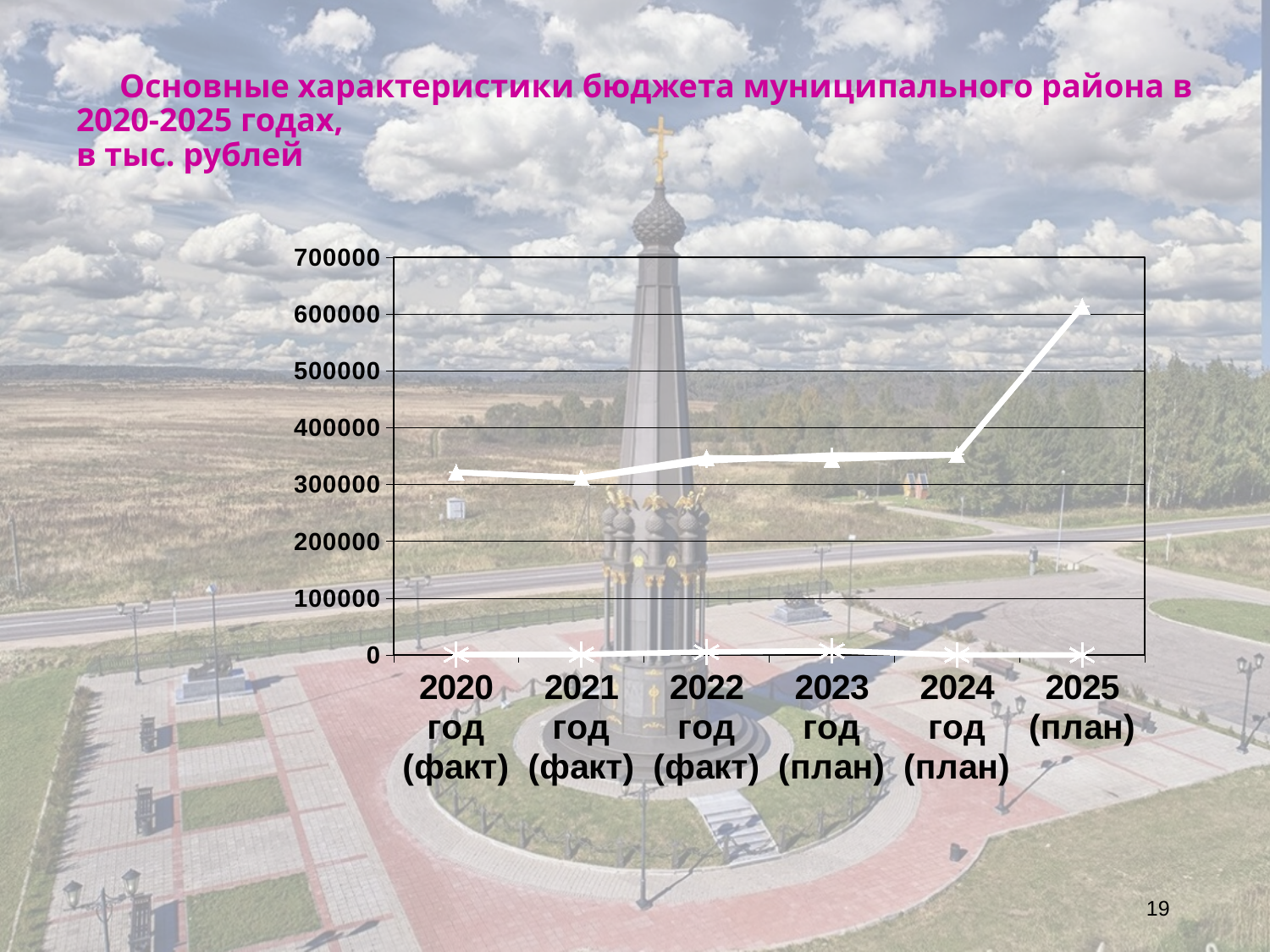
Which year has the highest value for the upper (triangle-marker) line? 2025 (план) Which is larger for the upper line: the value for 2021 год (факт) or for 2022 год (факт)? 2022 год (факт) Does the upper line rise or fall between 2024 год (план) and 2025 (план)? rise Is the value of the upper line for 2025 (план) greater or less than 500000? greater Which is larger for the upper line: the value for 2020 год (факт) or for 2025 (план)? 2025 (план) Is the value of the upper line for 2021 год (факт) greater or less than 400000? less In what units are the values on the slide expressed, according to the title? тыс. рублей What kind of chart is shown on the slide? line chart What is the highest value shown on the vertical axis of the chart? 700000 Is the value of the upper line for 2024 год (план) greater or less than 400000? less How many categories (years) are shown on the x axis of the chart? 6